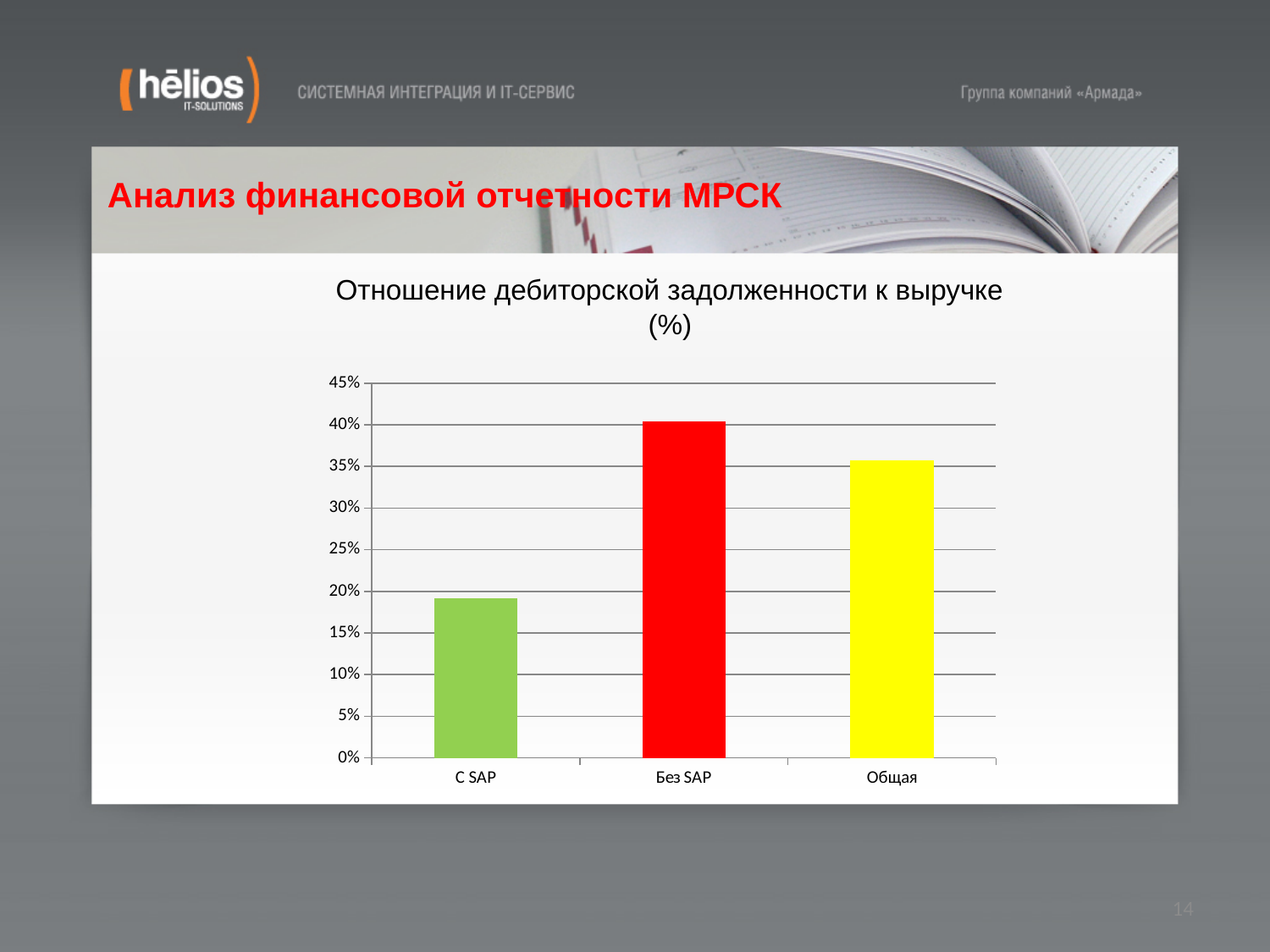
Which is larger, the value for С SAP or the value for Общая? Общая What is the title of the chart? Отношение дебиторской задолженности к выручке (%) Which is larger, the value for Без SAP or the value for Общая? Без SAP Is the value for С SAP greater or less than 20%? less Is the value for С SAP greater or less than 15%? greater What kind of chart is shown on the slide? bar chart Is the value for Общая greater or less than 40%? less What colour is the bar for Без SAP? red Which category has the highest value in the chart? Без SAP Which category has the lowest value in the chart? С SAP How many categories are shown on the x axis of the chart? 3